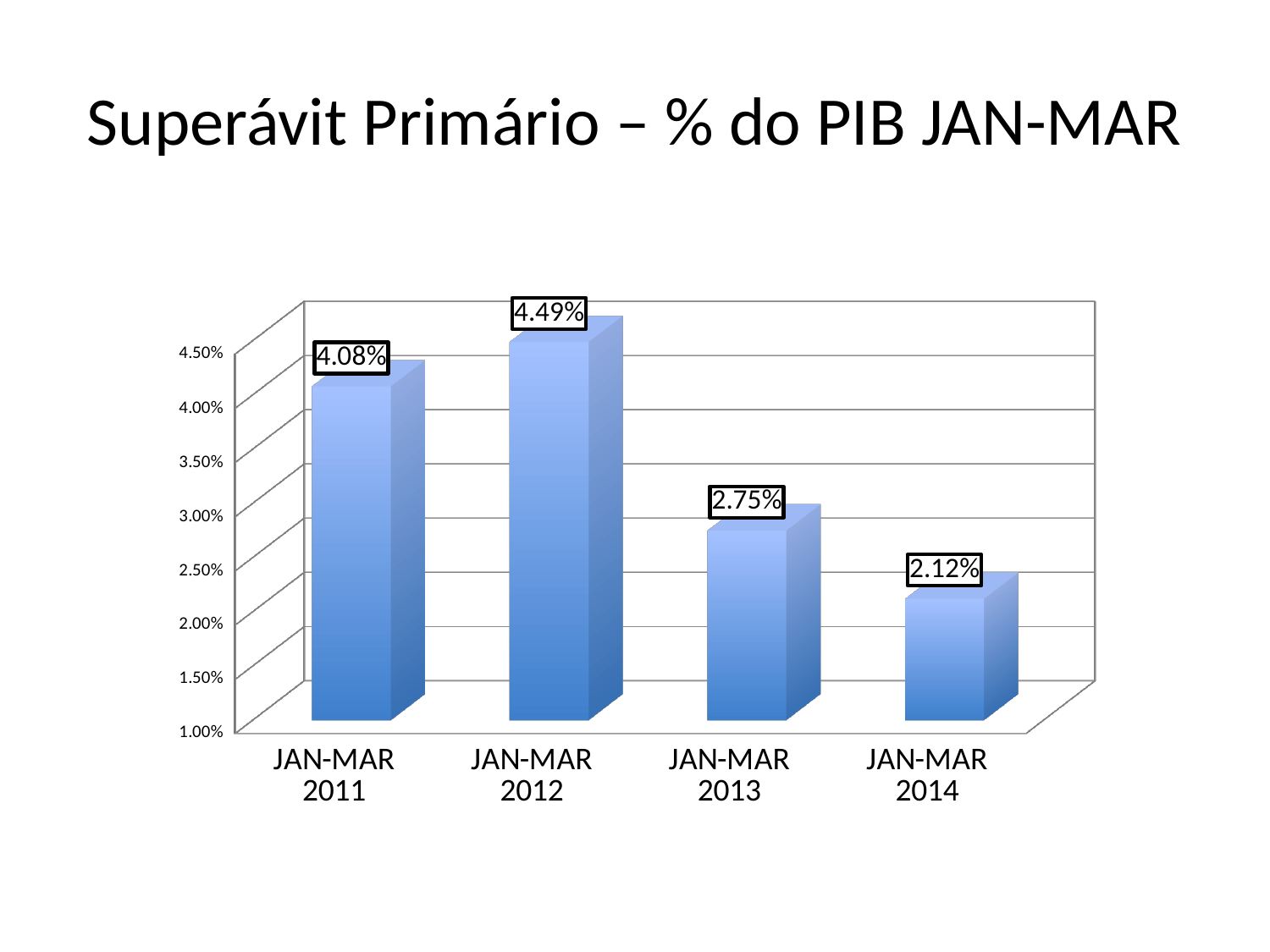
What is the value for JAN-MAR 2013? 2.75% What is the difference between the values for JAN-MAR 2013 and JAN-MAR 2014? 0.63% Which period has the lowest value? JAN-MAR 2014 Which is larger, the value for JAN-MAR 2011 or JAN-MAR 2013? JAN-MAR 2011 How many periods are shown on the chart? 4 Which period has the highest value? JAN-MAR 2012 What is the title of the slide? Superávit Primário – % do PIB JAN-MAR What kind of chart is shown on the slide? Bar chart What is the value for JAN-MAR 2012? 4.49% What is the difference between the values for JAN-MAR 2012 and JAN-MAR 2011? 0.41% What is the value for JAN-MAR 2014? 2.12% What is the value for JAN-MAR 2011? 4.08%